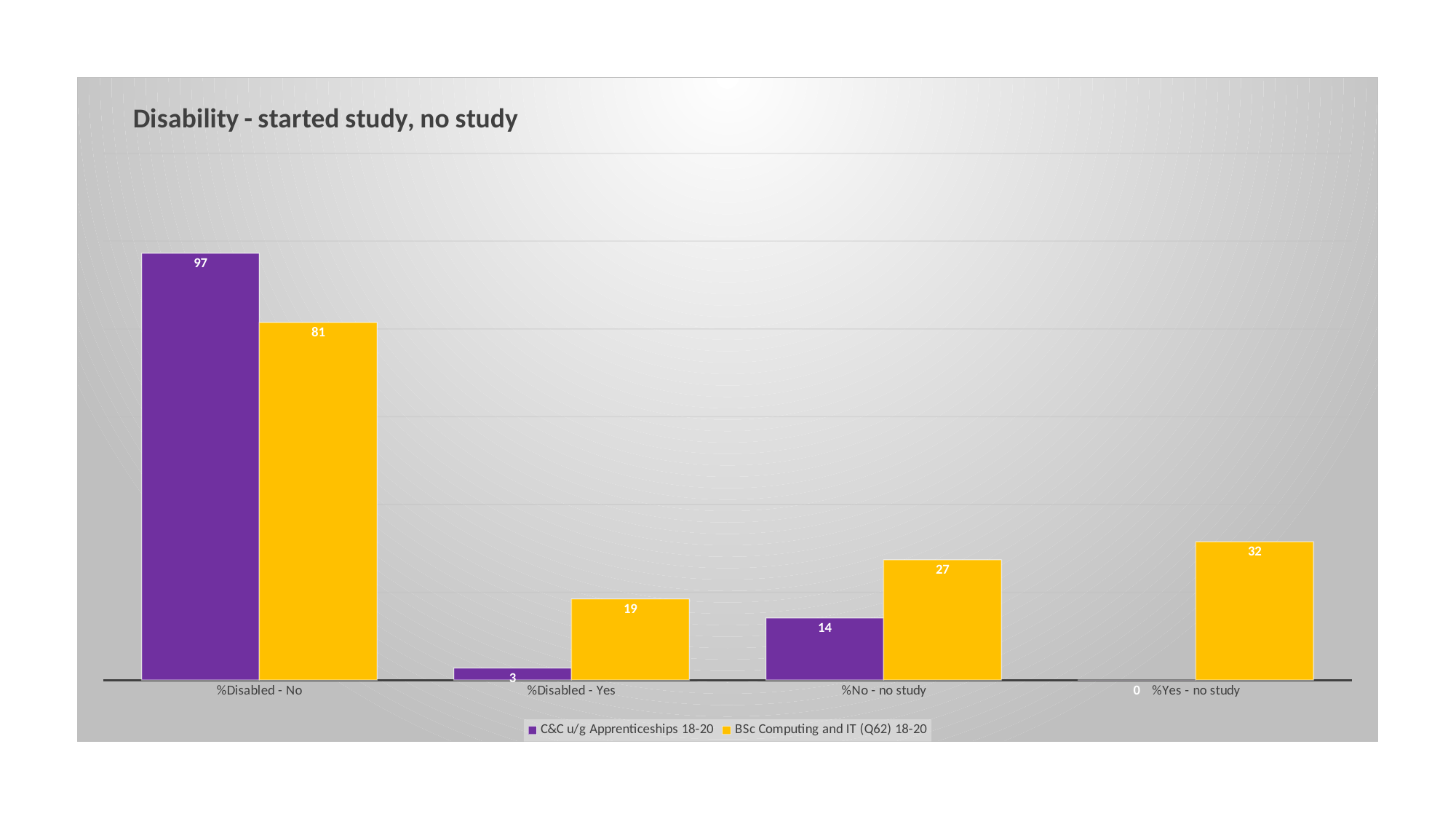
In the %Disabled - Yes category, which series has the larger value? BSc Computing and IT (Q62) 18-20 What is the value for BSc Computing and IT (Q62) 18-20 in the %No - no study category? 27 How many categories are shown on the x axis? 4 What is the difference between the BSc Computing and IT (Q62) 18-20 value and the C&C u/g Apprenticeships 18-20 value in the %No - no study category? 13 What is the value for C&C u/g Apprenticeships 18-20 in the %Yes - no study category? 0 How many series does the legend list? 2 Which category has the highest value for BSc Computing and IT (Q62) 18-20? %Disabled - No What type of chart is shown on the slide? Bar chart What is the difference between the two series in the %Disabled - No category? 16 What is the value for BSc Computing and IT (Q62) 18-20 in the %Disabled - Yes category? 19 What is the value for C&C u/g Apprenticeships 18-20 in the %Disabled - No category? 97 Which category has the lowest value for C&C u/g Apprenticeships 18-20? %Yes - no study